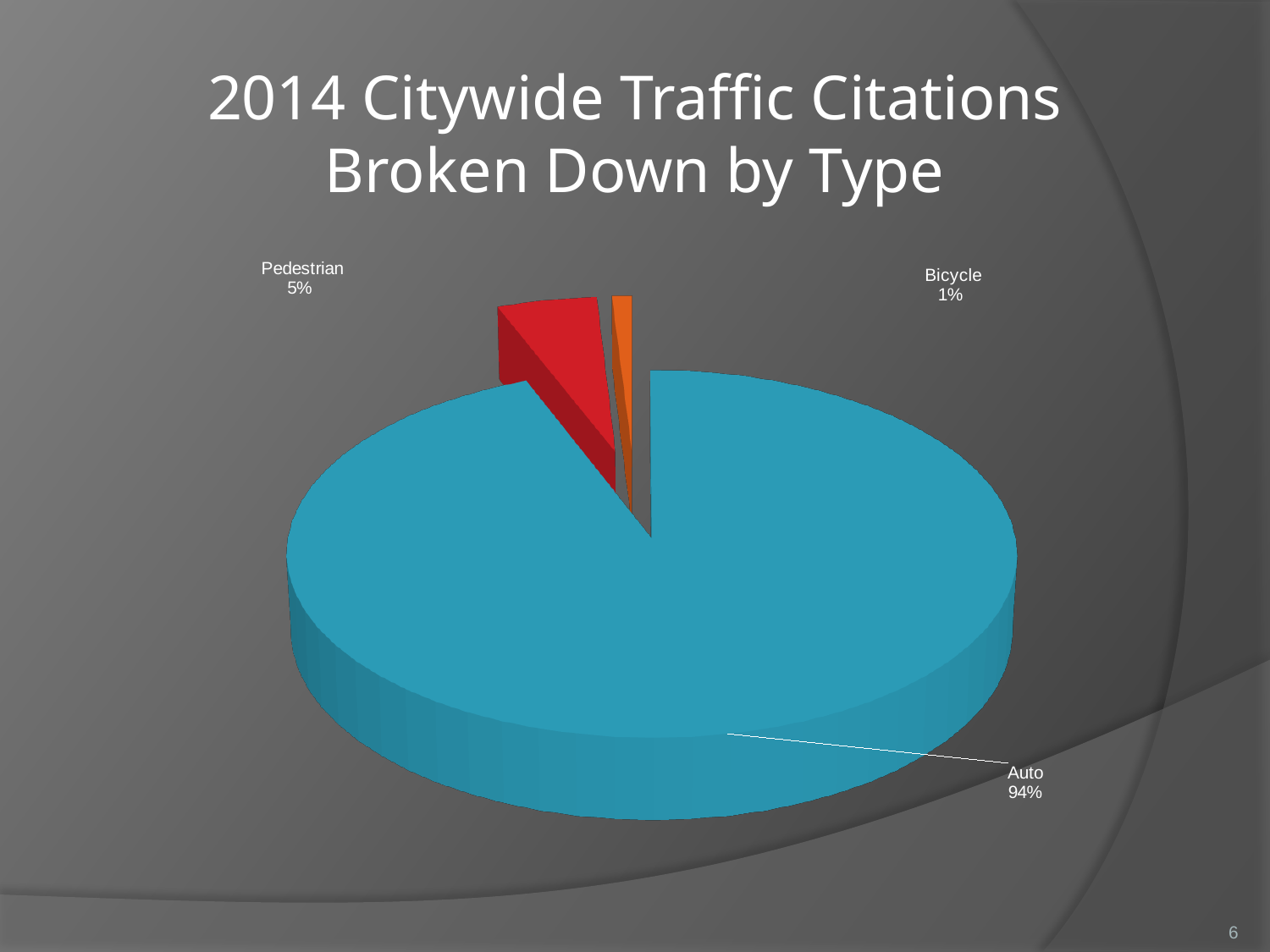
What share of the 2014 citywide traffic citations were Auto citations? 94% What kind of chart is shown on the slide? pie chart Which citation type has the smallest share of the pie? Bicycle What is the difference in percentage points between the Auto and Pedestrian shares? 89 Which is larger, the Pedestrian share or the Bicycle share? Pedestrian What share of the citations were Pedestrian citations? 5% Which citation type has the largest share of the pie? Auto How many citation types are shown in the pie chart? 3 What is the title of the chart on the slide? 2014 Citywide Traffic Citations Broken Down by Type What is the difference in percentage points between the Pedestrian and Bicycle shares? 4 What colour is the Auto slice of the pie? blue What share of the citations were Bicycle citations? 1%